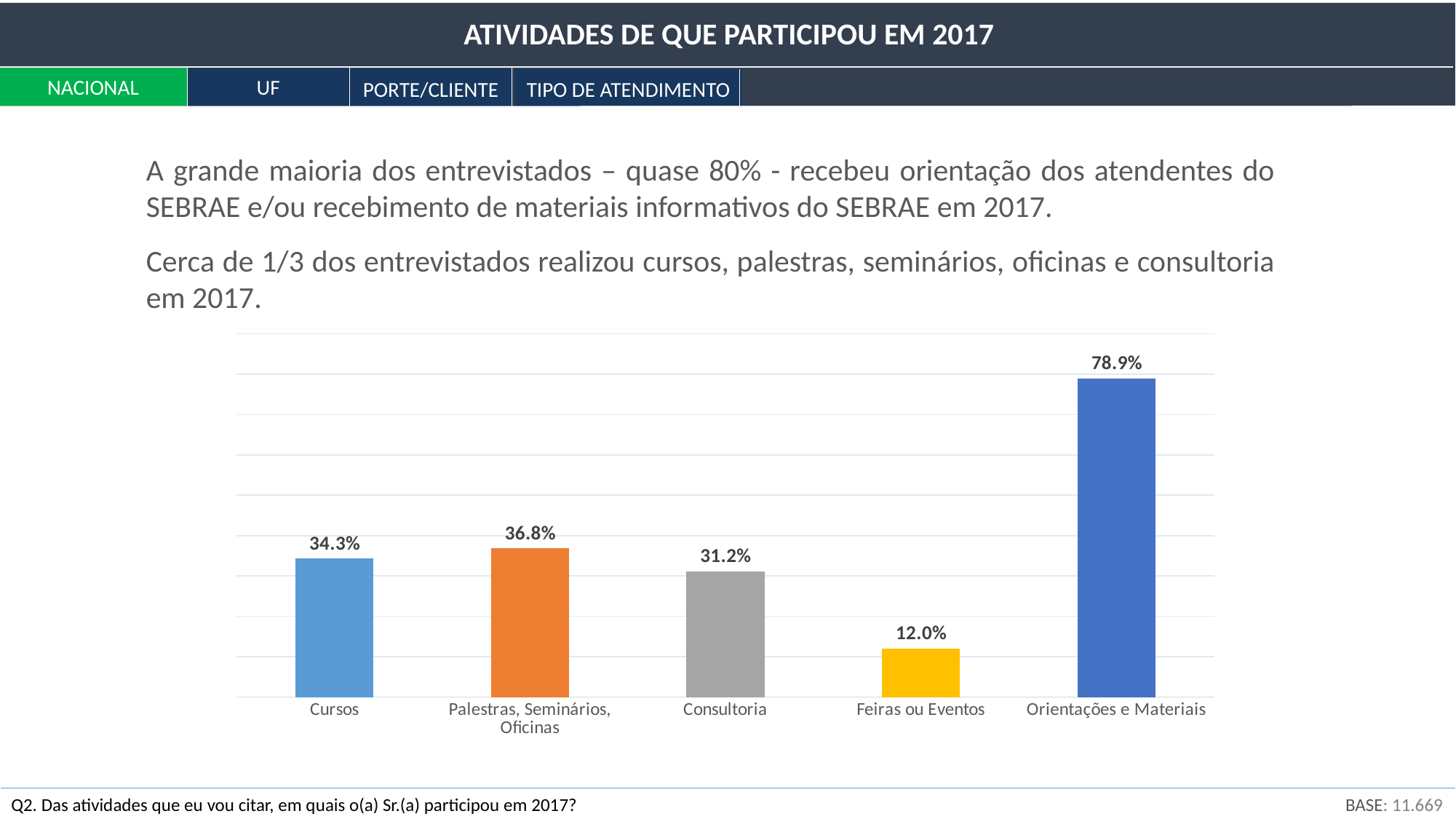
What is the value for Consultoria? 31.2% Which category has the highest value? Orientações e Materiais What colour is the bar for Feiras ou Eventos? Yellow Which is larger, the value for Palestras, Seminários, Oficinas or the value for Consultoria? Palestras, Seminários, Oficinas What is the value for Cursos? 34.3% How many categories are shown in the chart? 5 What is the value for Feiras ou Eventos? 12.0% What is the value for Palestras, Seminários, Oficinas? 36.8% What is the difference between the values for Orientações e Materiais and Cursos? 44.6% Which category has the lowest value? Feiras ou Eventos What kind of chart is shown on the slide? Bar chart What is the value for Orientações e Materiais? 78.9%